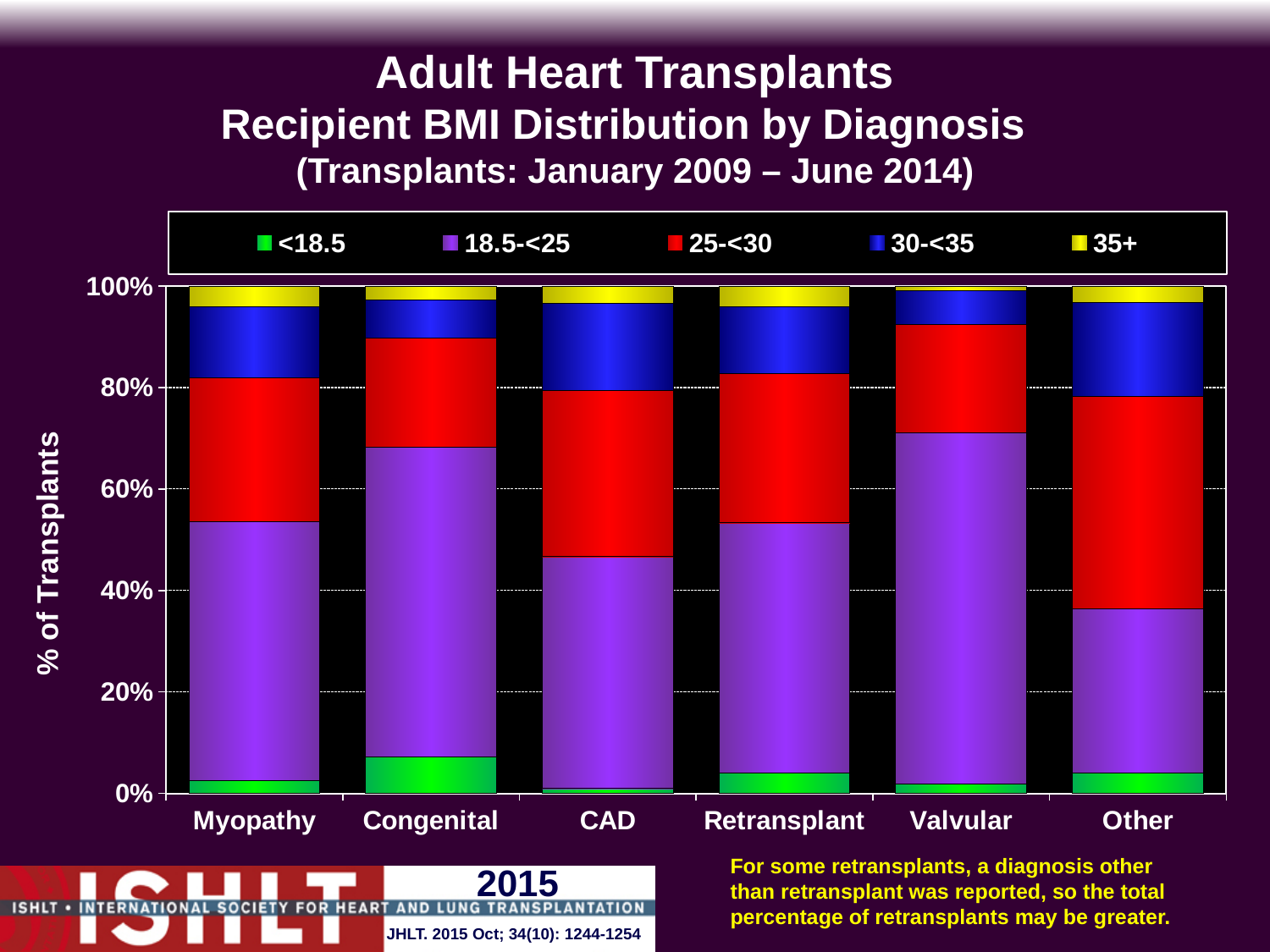
Which diagnosis has the smallest 18.5-<25 BMI segment? Other Is the combined share of recipients with BMI below 25 for Valvular greater or less than 60%? greater What is the label of the y axis? % of Transplants Is the combined share of recipients with BMI below 25 for Other greater or less than 40%? less Is the 18.5-<25 BMI segment larger for Congenital or for CAD? Congenital Which diagnosis has the largest <18.5 BMI segment? Congenital Which transplant period does the chart subtitle cover? January 2009 – June 2014 How many BMI categories does the legend list? 5 How many diagnosis categories are shown on the x axis? 6 Which diagnosis has the largest 18.5-<25 BMI segment? Valvular What kind of chart is shown on the slide? Stacked bar chart Which diagnosis has the largest 25-<30 BMI segment? Other